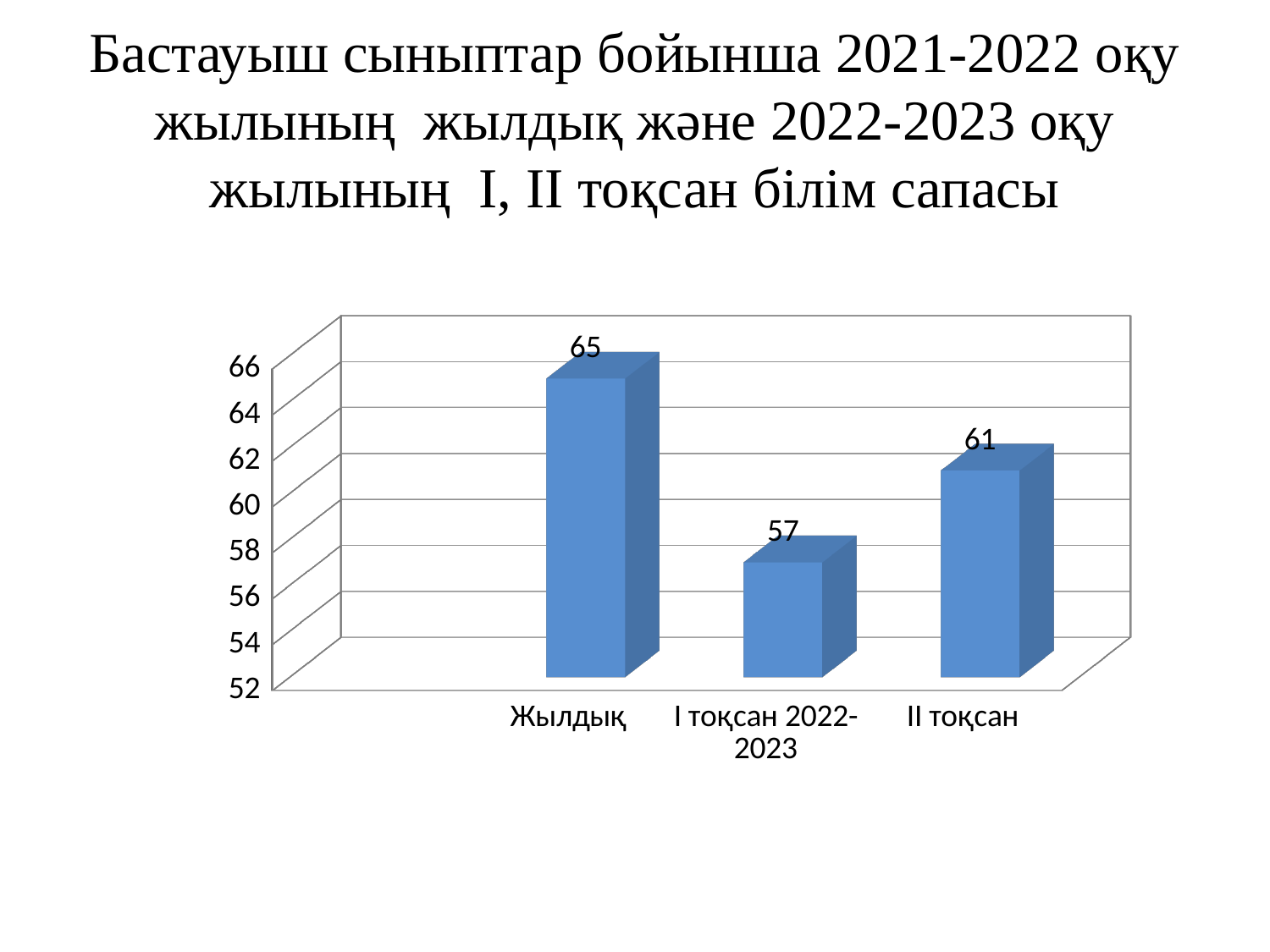
Which category has the highest value? Жылдық Is the value for Жылдық greater or less than 60? greater What kind of chart is shown on the slide? bar chart How many categories are shown on the x axis? 3 What is the difference between the values for Жылдық and I тоқсан 2022-2023? 8 What is the difference between the values for II тоқсан and I тоқсан 2022-2023? 4 What is the value for I тоқсан 2022-2023? 57 What is the value for Жылдық? 65 Which category has the lowest value? I тоқсан 2022-2023 What is the highest value shown on the vertical axis? 66 Which is larger, the value for II тоқсан or the value for I тоқсан 2022-2023? II тоқсан What is the value for II тоқсан? 61